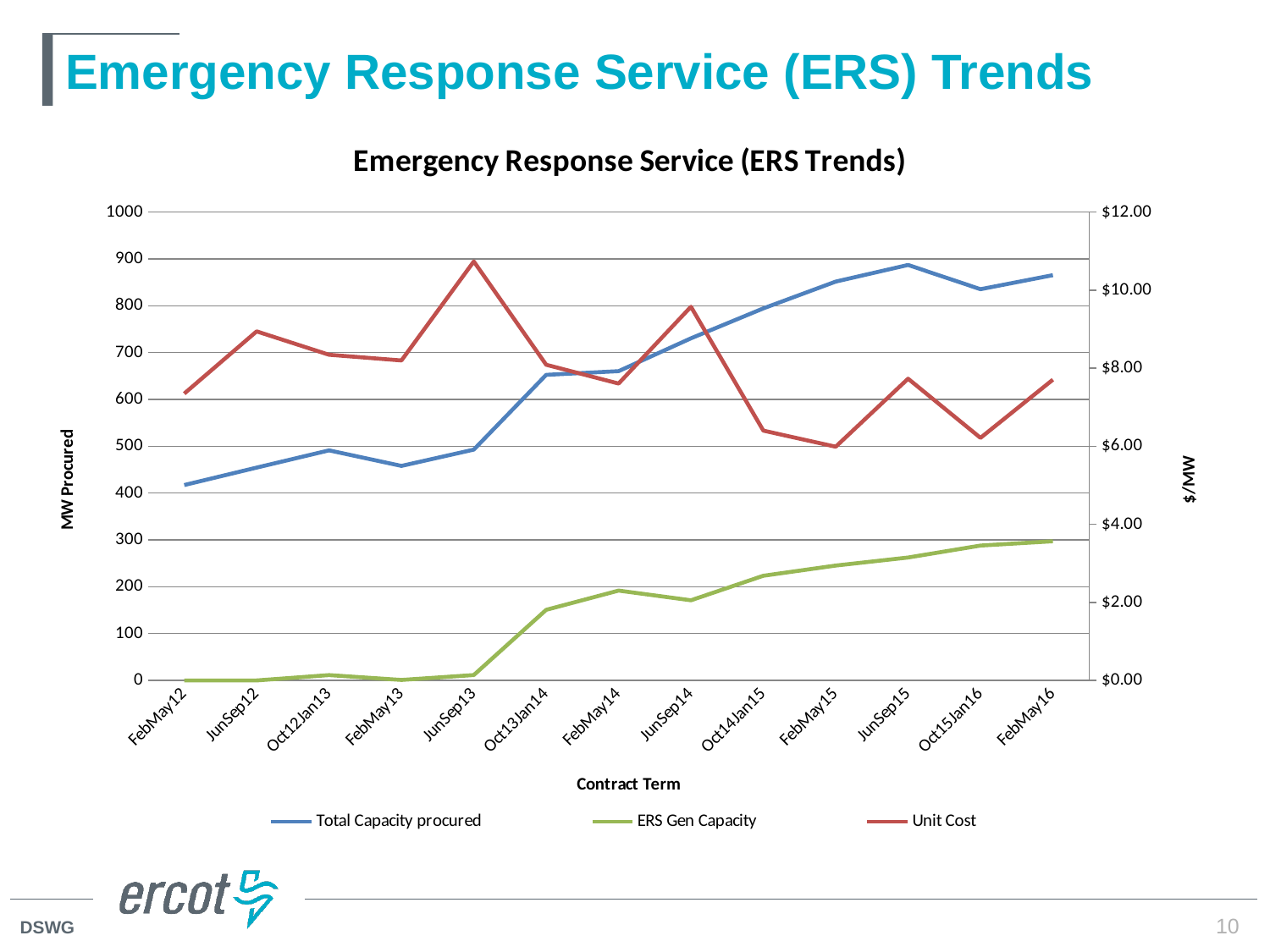
Does the ERS Gen Capacity generally rise or fall from FebMay12 to FebMay16? rise Is the ERS Gen Capacity for Oct13Jan14 greater or less than 100? greater Is the Unit Cost for FebMay15 greater or less than $8.00? less How many contract terms are shown along the x axis? 13 Is the Unit Cost for JunSep13 greater or less than $10.00? greater Which is larger, the Unit Cost for JunSep12 or for Oct14Jan15? JunSep12 How many series does the legend list? 3 What kind of chart is shown on the slide? Line chart In which contract term is the Total Capacity procured lowest? FebMay12 In which contract term is the Unit Cost highest? JunSep13 What is the label of the right-hand vertical axis? $/MW